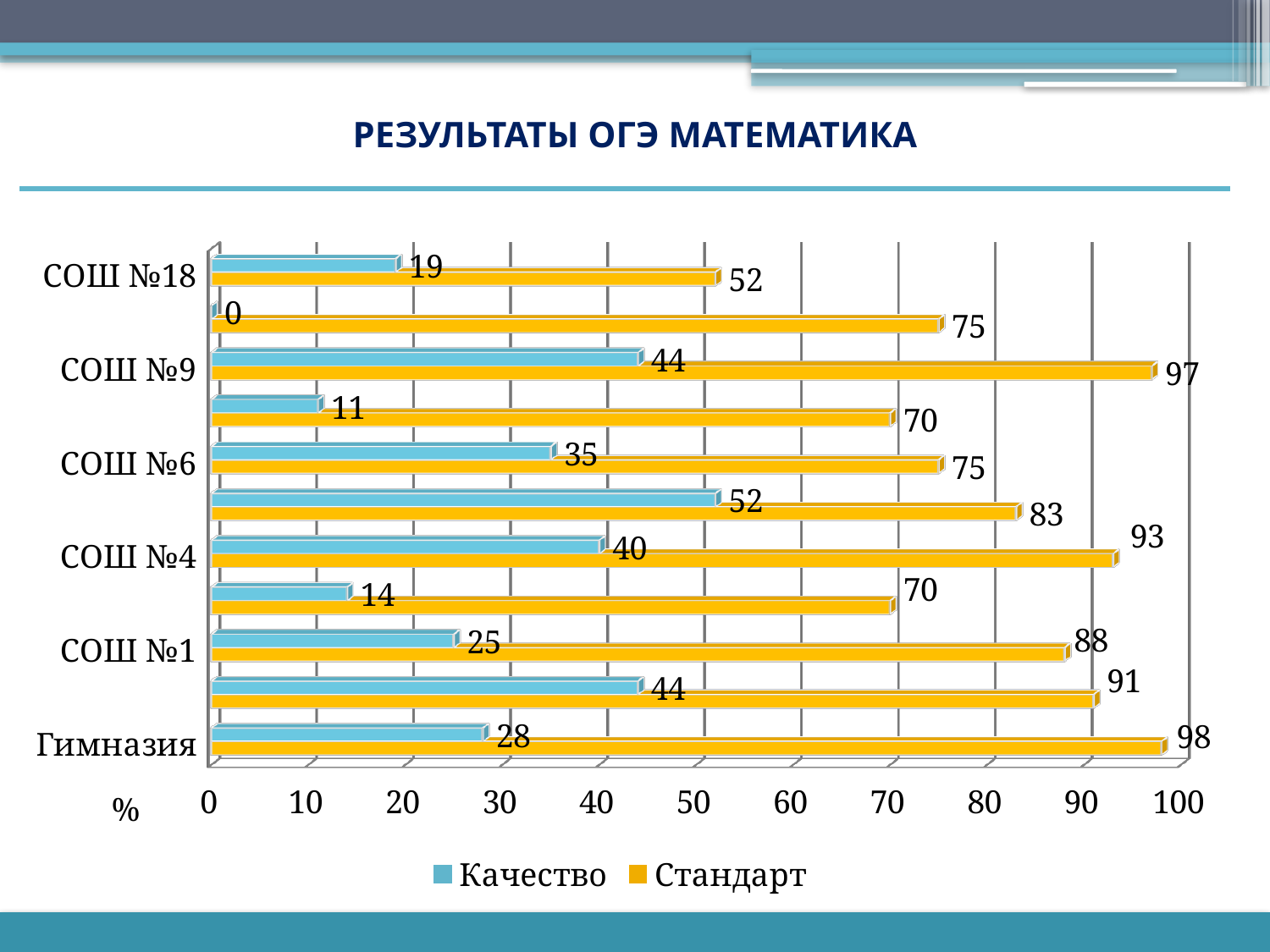
What kind of chart is shown on the slide? Bar chart Which labelled school has the lowest Стандарт value? СОШ №18 What is the Стандарт value for СОШ №9? 97 What is the Качество value for СОШ №18? 19 What is the title of the slide? РЕЗУЛЬТАТЫ ОГЭ МАТЕМАТИКА Which has the larger Качество value, СОШ №9 or СОШ №1? СОШ №9 What is the Стандарт value for Гимназия? 98 What is the difference between the Стандарт and Качество values for СОШ №6? 40 How many series does the legend list? 2 Which labelled school has the highest Стандарт value? Гимназия What is the Качество value for СОШ №4? 40 What is the Стандарт value for СОШ №1? 88